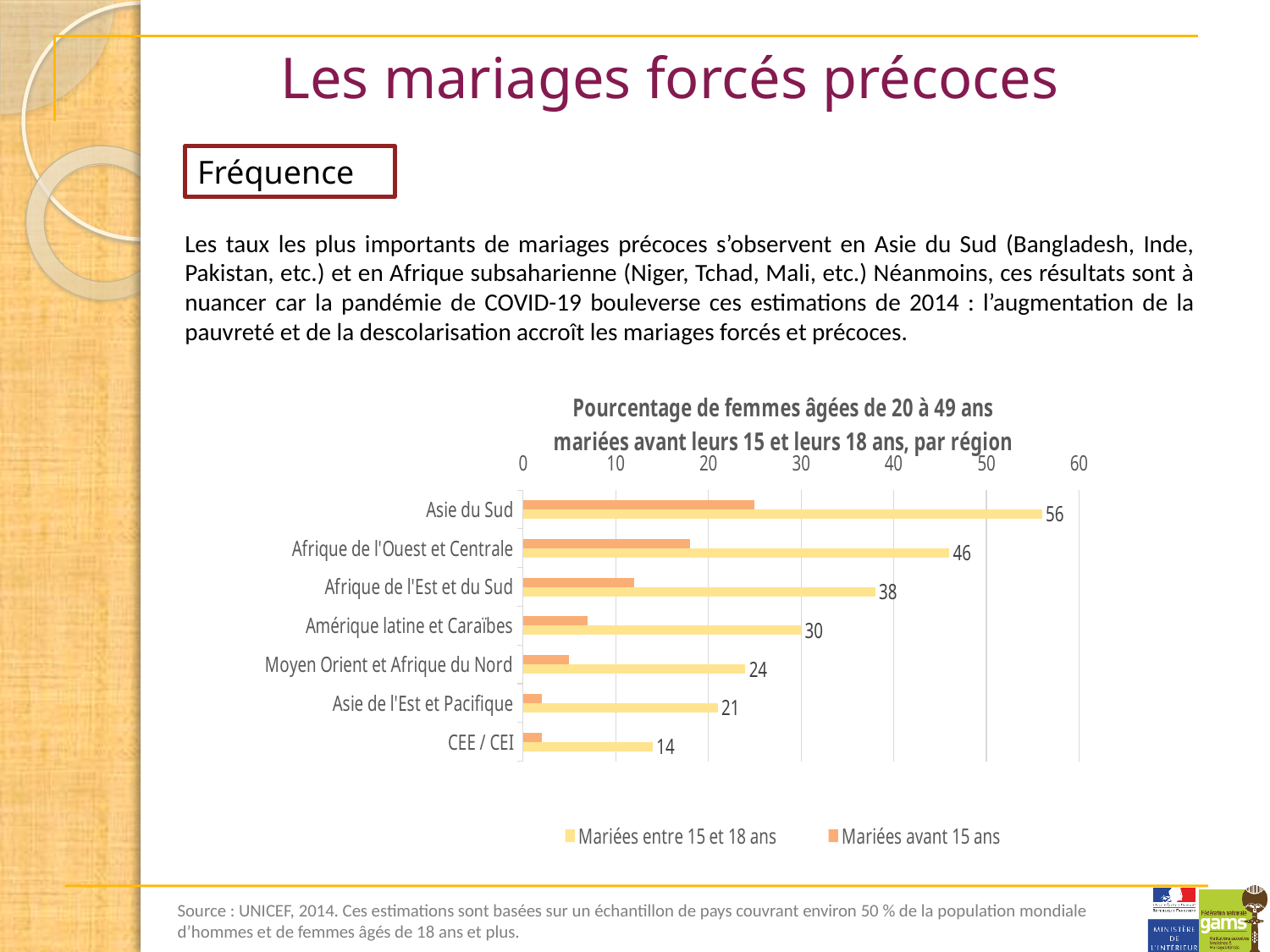
What is the value for Asie du Sud in the 'Mariées entre 15 et 18 ans' series? 56 Which region has the highest value for 'Mariées entre 15 et 18 ans'? Asie du Sud What type of chart is shown on the slide? bar chart What is the difference between the 'Mariées entre 15 et 18 ans' values for Afrique de l'Ouest et Centrale and Afrique de l'Est et du Sud? 8 Which region has the lowest value for 'Mariées entre 15 et 18 ans'? CEE / CEI What is the value for Amérique latine et Caraïbes in the 'Mariées entre 15 et 18 ans' series? 30 How many series does the legend list? 2 Is the 'Mariées avant 15 ans' value for Asie du Sud greater or less than 20? greater What is the value for CEE / CEI in the 'Mariées entre 15 et 18 ans' series? 14 Which has a larger 'Mariées entre 15 et 18 ans' value: Moyen Orient et Afrique du Nord or Asie de l'Est et Pacifique? Moyen Orient et Afrique du Nord Is the 'Mariées avant 15 ans' value for Amérique latine et Caraïbes greater or less than 10? less How many regions are shown in the chart? 7